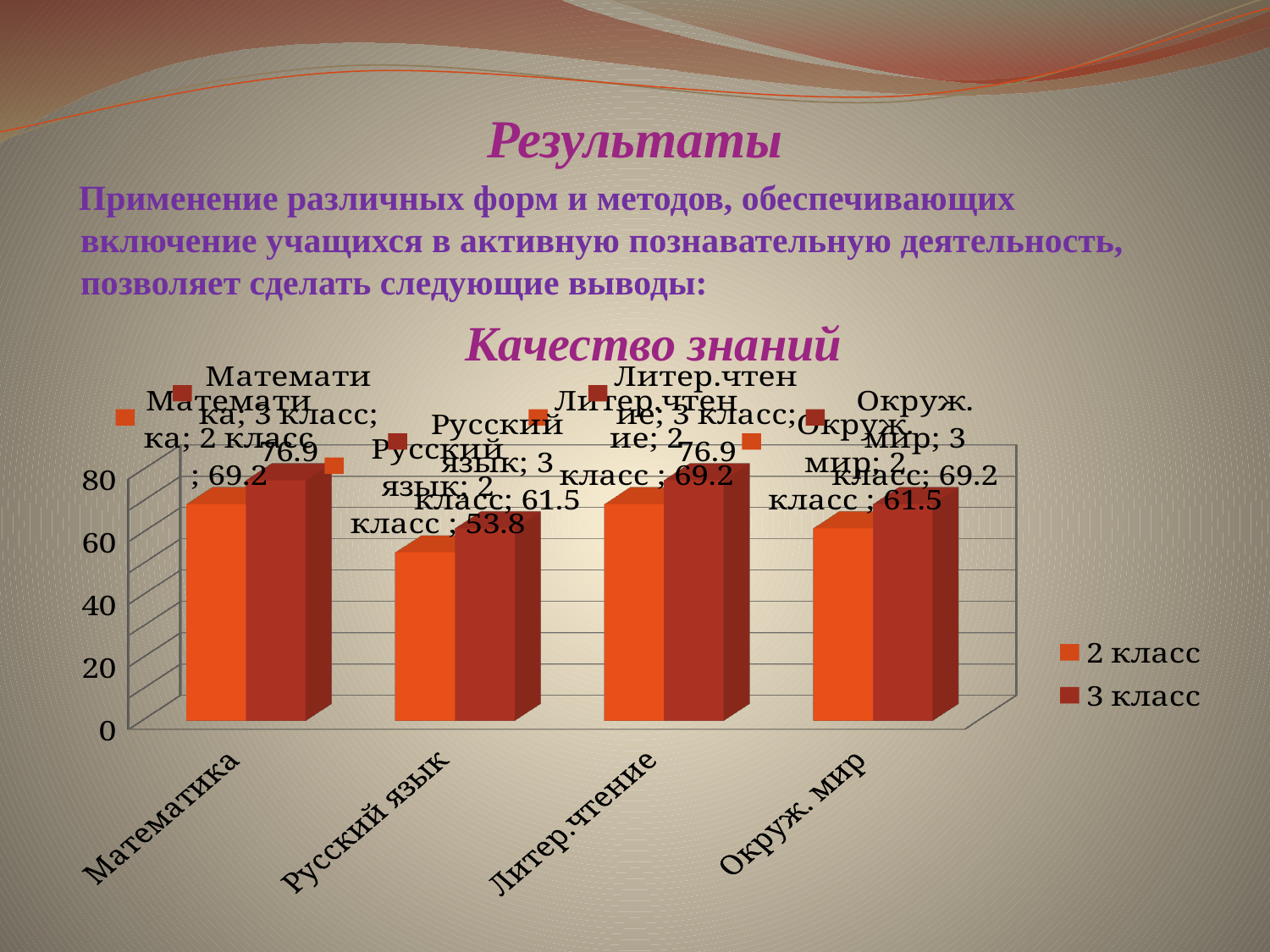
Is the 2 класс value for Русский язык greater or less than 60? less How many series does the legend list? 2 Which category has the lowest value in the 2 класс series? Русский язык What is the value for Русский язык in the 3 класс series? 61.5 What is the value for Математика in the 2 класс series? 69.2 What is the title of the chart? Качество знаний What kind of chart is shown on the slide? bar chart Which is larger: the 3 класс value for Окруж. мир or the 3 класс value for Математика? Математика What is the difference between the 3 класс and 2 класс values for Русский язык? 7.7 What is the value for Литер.чтение in the 3 класс series? 76.9 How many categories are shown on the x axis? 4 What is the value for Окруж. мир in the 2 класс series? 61.5